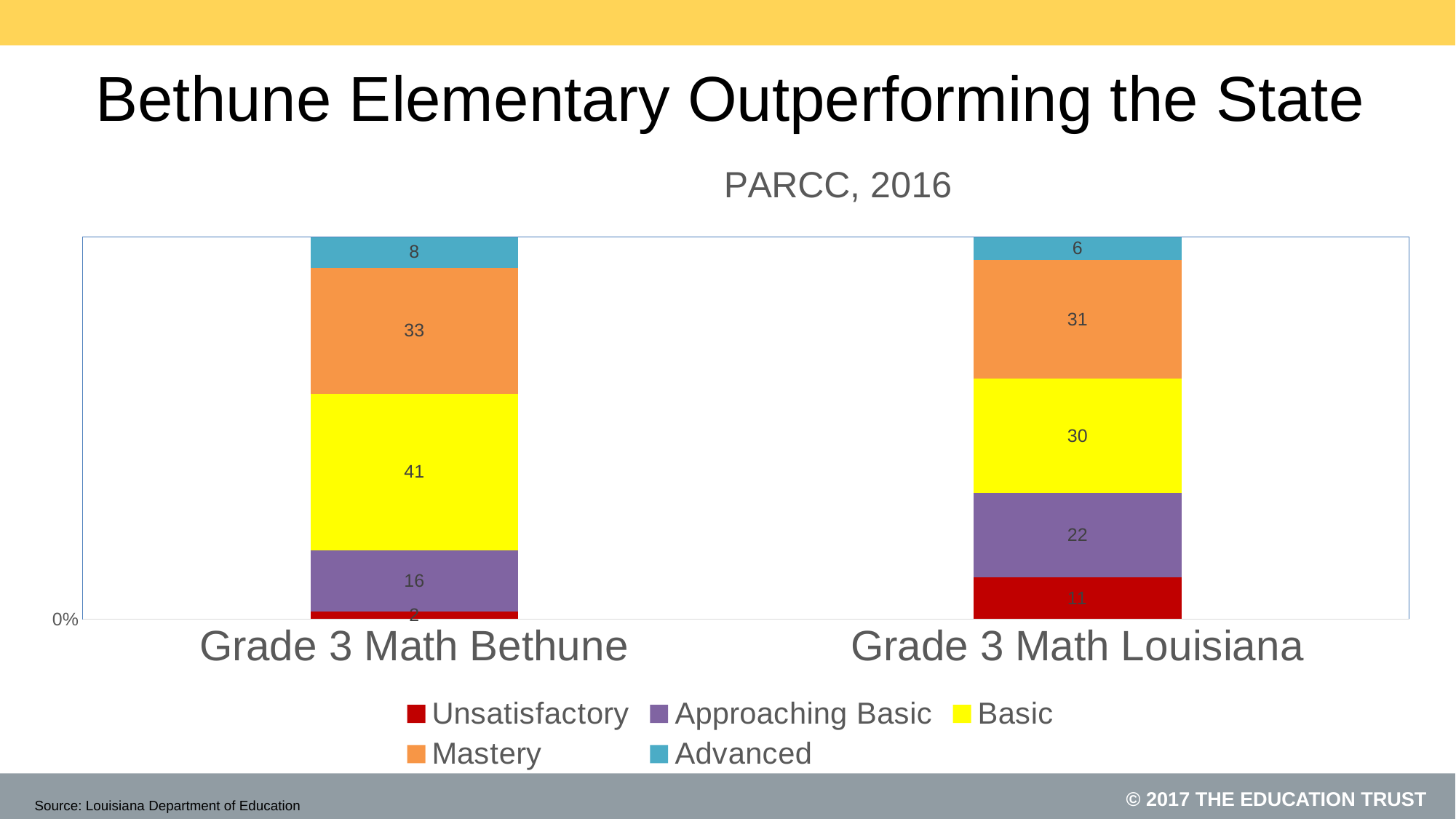
What is the Unsatisfactory value for Grade 3 Math Louisiana? 11 What is the subtitle shown above the chart? PARCC, 2016 What type of chart is shown on the slide? Stacked bar chart What is the Approaching Basic value for Grade 3 Math Louisiana? 22 Which category has the larger Mastery value, Grade 3 Math Bethune or Grade 3 Math Louisiana? Grade 3 Math Bethune What is the Mastery value for Grade 3 Math Louisiana? 31 How many categories are shown on the x axis? 2 What is the difference between the Basic values for Grade 3 Math Bethune and Grade 3 Math Louisiana? 11 What is the Basic value for Grade 3 Math Bethune? 41 What is the total of the stacked bar for Grade 3 Math Louisiana? 100 How many series does the legend list? 5 What is the Advanced value for Grade 3 Math Bethune? 8